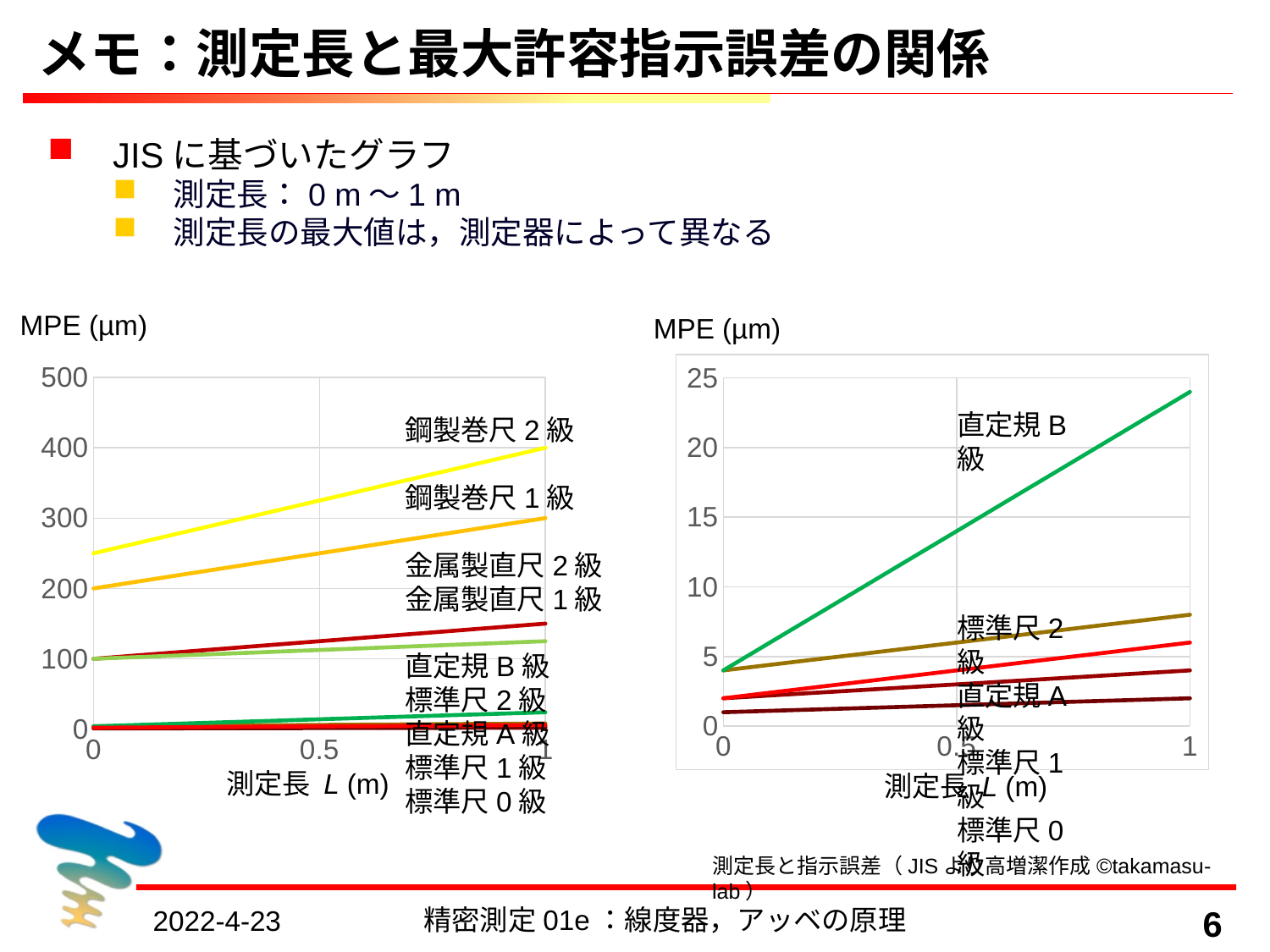
In the left chart, at L = 1 m, which has the larger MPE: 鋼製巻尺2級 or 鋼製巻尺1級? 鋼製巻尺2級 In the left chart, which series has the highest MPE at L = 1 m? 鋼製巻尺2級 What kind of chart is the left chart on the slide? line chart In the right chart, which series has the highest MPE at L = 1 m? 直定規B級 In the right chart, is the MPE of 標準尺2級 at L = 1 m greater or less than 10? less How many series are labelled in the right chart? 5 In the right chart, is the MPE of 直定規B級 at L = 1 m greater or less than 20? greater In the left chart, what is the MPE of 鋼製巻尺1級 at L = 0 m? 200 What is the y-axis label of the left chart? MPE (μm) In the left chart, does the MPE of 鋼製巻尺2級 rise or fall as the measuring length L increases? rise In the right chart, which series has the lowest MPE at L = 1 m? 標準尺0級 In the left chart, is the MPE of 鋼製巻尺2級 at L = 1 m greater or less than 300? greater